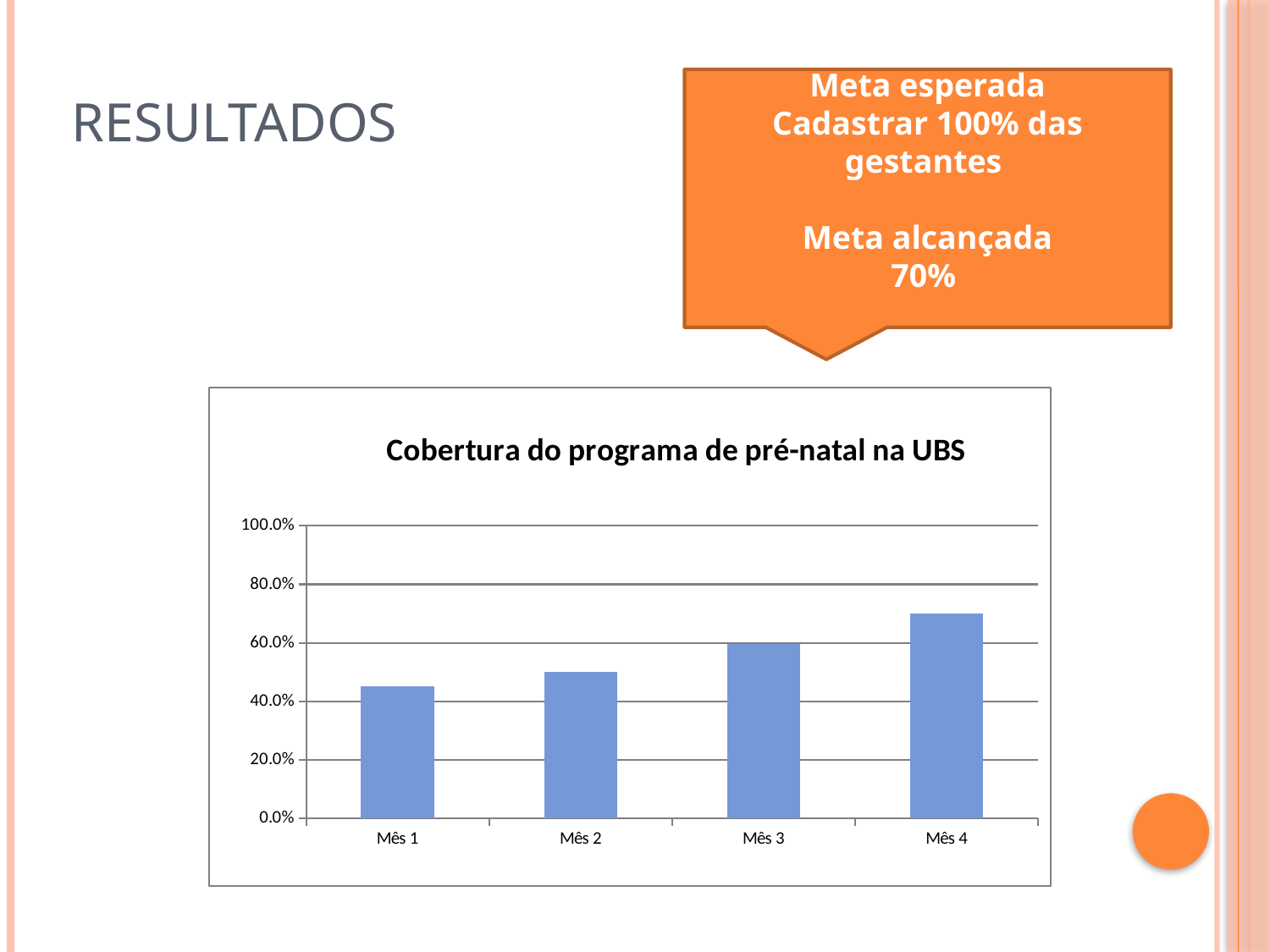
How many months (categories) are plotted in the chart? 4 What type of chart is shown on the slide? Bar chart Do the coverage values rise or fall from Mês 1 to Mês 4? Rise Is the value for Mês 4 greater or less than 60.0%? greater Which month has the highest coverage in the chart? Mês 4 Is the value for Mês 4 greater or less than 80.0%? less What is the title of the chart? Cobertura do programa de pré-natal na UBS Which is larger, the value for Mês 2 or the value for Mês 4? Mês 4 Is the value for Mês 1 greater or less than 40.0%? greater Which month has the lowest coverage in the chart? Mês 1